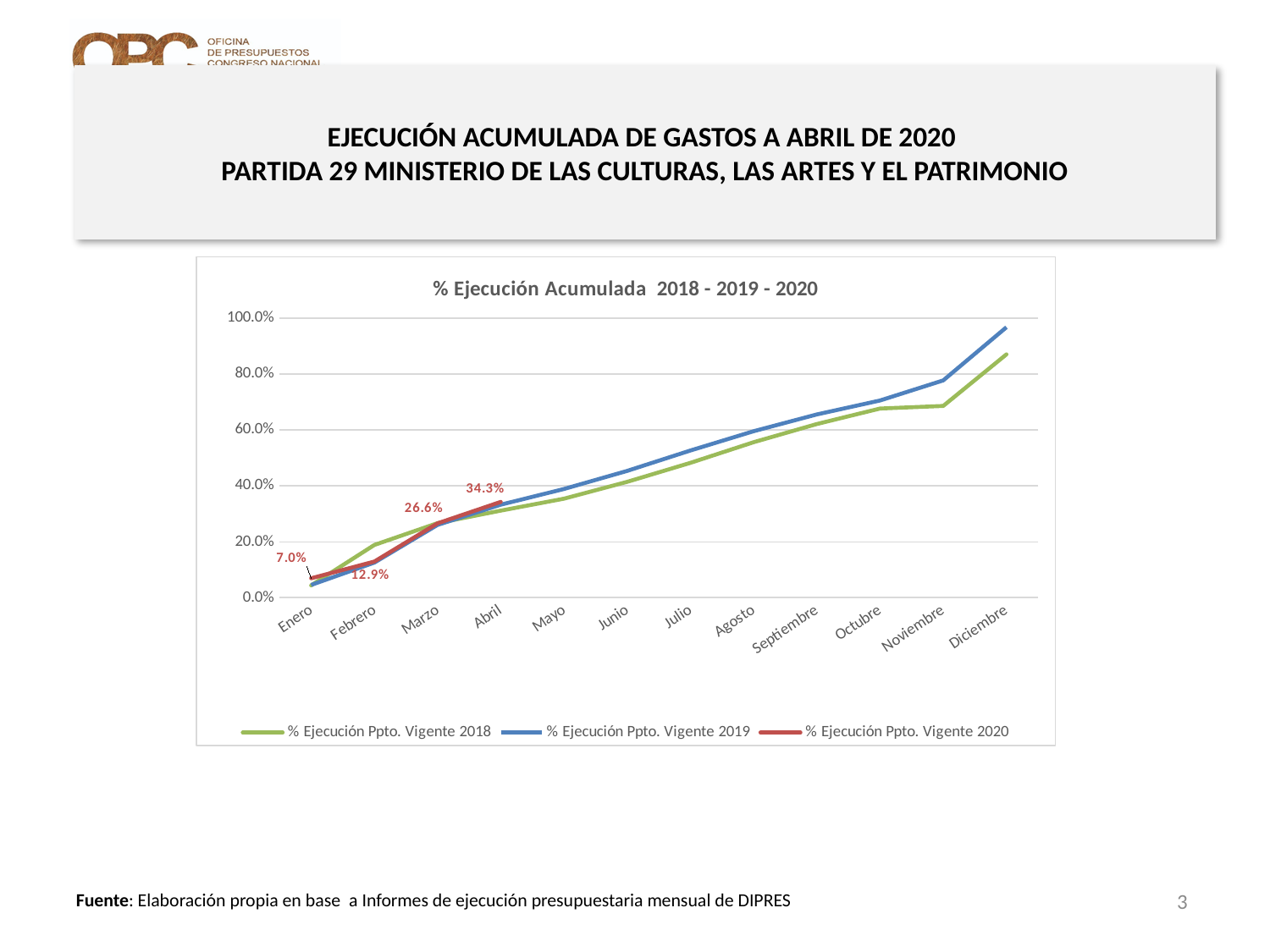
How many series does the legend list? 3 What is the value of % Ejecución Ppto. Vigente 2020 in Febrero? 12.9% What is the value of % Ejecución Ppto. Vigente 2020 in Enero? 7.0% What kind of chart is shown on the slide? line chart What is the title of the chart? % Ejecución Acumulada 2018 - 2019 - 2020 Is the value for % Ejecución Ppto. Vigente 2019 in Diciembre greater or less than 80%? greater Which series has the larger value in Diciembre, % Ejecución Ppto. Vigente 2018 or % Ejecución Ppto. Vigente 2019? % Ejecución Ppto. Vigente 2019 Which month has the highest labelled value for % Ejecución Ppto. Vigente 2020? Abril By how much did % Ejecución Ppto. Vigente 2020 increase from Marzo to Abril? 7.7% What is the value of % Ejecución Ppto. Vigente 2020 in Marzo? 26.6% What is the value of % Ejecución Ppto. Vigente 2020 in Abril? 34.3% How many months are shown along the x axis? 12